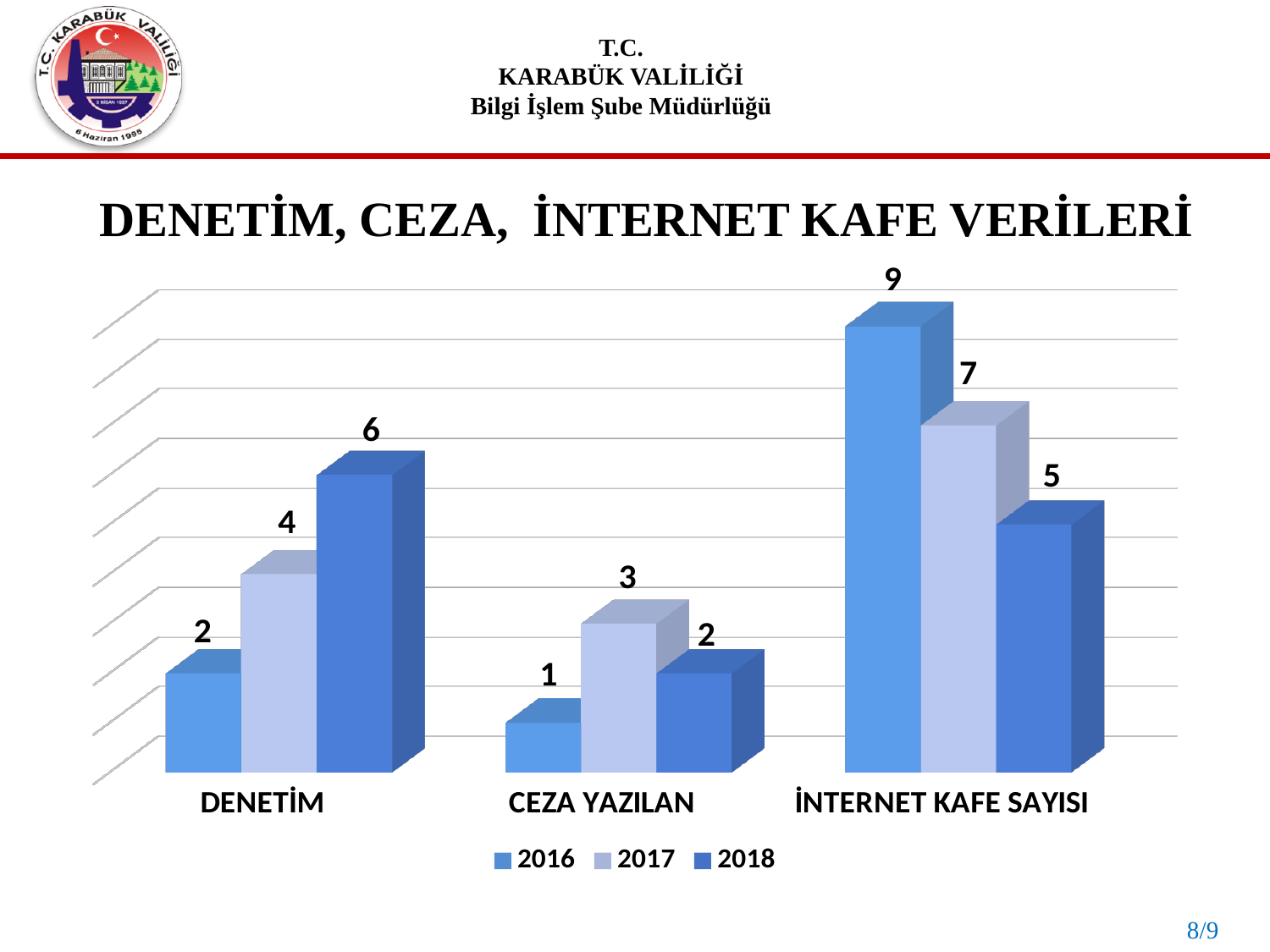
How many series does the legend list? 3 What is the title of the chart? DENETİM, CEZA, İNTERNET KAFE VERİLERİ Do the values for İNTERNET KAFE SAYISI rise or fall from 2016 to 2018? Fall What is the value for İNTERNET KAFE SAYISI in 2016? 9 What kind of chart is shown on the slide? Bar chart Which is larger: the 2017 value for DENETİM or the 2017 value for CEZA YAZILAN? DENETİM Which category has the highest value in 2016? İNTERNET KAFE SAYISI What is the value for CEZA YAZILAN in 2017? 3 How many categories are shown on the x axis? 3 Which category has the lowest value in 2018? CEZA YAZILAN What is the difference between the 2016 and 2018 values for İNTERNET KAFE SAYISI? 4 What is the value for DENETİM in 2018? 6